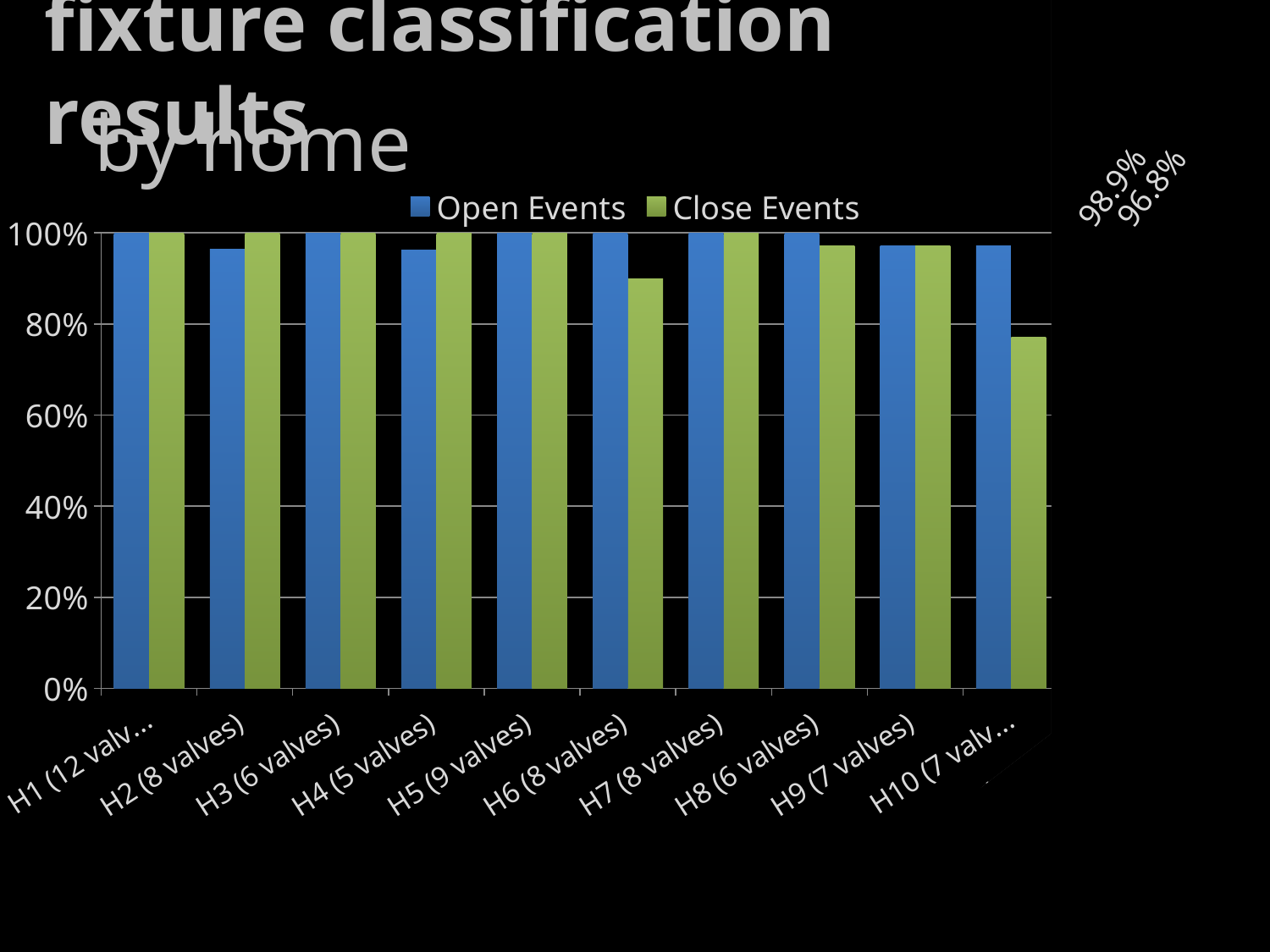
How many homes (categories) are shown on the x axis? 10 What kind of chart is shown on the slide? bar chart Is the Open Events value for H2 (8 valves) greater or less than 80%? greater Is the Close Events value for H6 (8 valves) greater or less than 80%? greater For H10, which is larger: Open Events or Close Events? Open Events Which series is shown in green? Close Events For H6 (8 valves), which is larger: Open Events or Close Events? Open Events Which home has the lowest Close Events value? H10 (7 valves) What are the two series named in the legend? Open Events and Close Events What is the Open Events value for H1 (12 valves)? 100% How many series does the legend list? 2 Is the Close Events value for H10 greater or less than 80%? less